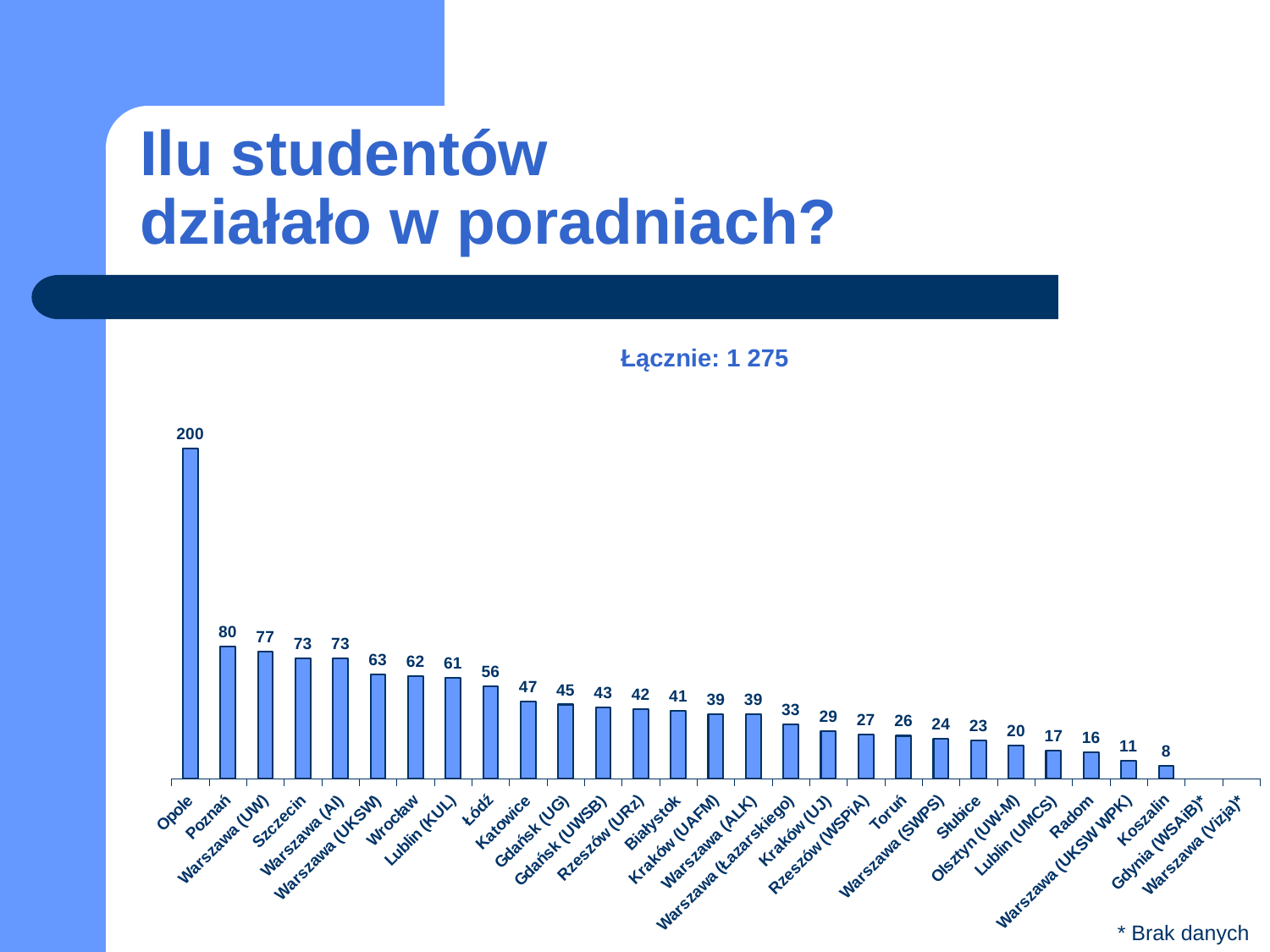
What is the difference between the values for Katowice and Toruń? 21 What kind of chart is shown on the slide? bar chart What is the value for Lublin (KUL)? 61 What total is stated above the chart (Łącznie)? 1 275 Which is larger, the value for Wrocław or the value for Kraków (UJ)? Wrocław Among the categories with a plotted value, which has the lowest value? Koszalin Which category has the highest value? Opole What is the value for Warszawa (Łazarskiego)? 33 How many categories are listed on the x axis? 29 How many students are shown for Opole? 200 What is the difference between the values for Opole and Poznań? 120 Which is larger, the value for Szczecin or the value for Radom? Szczecin